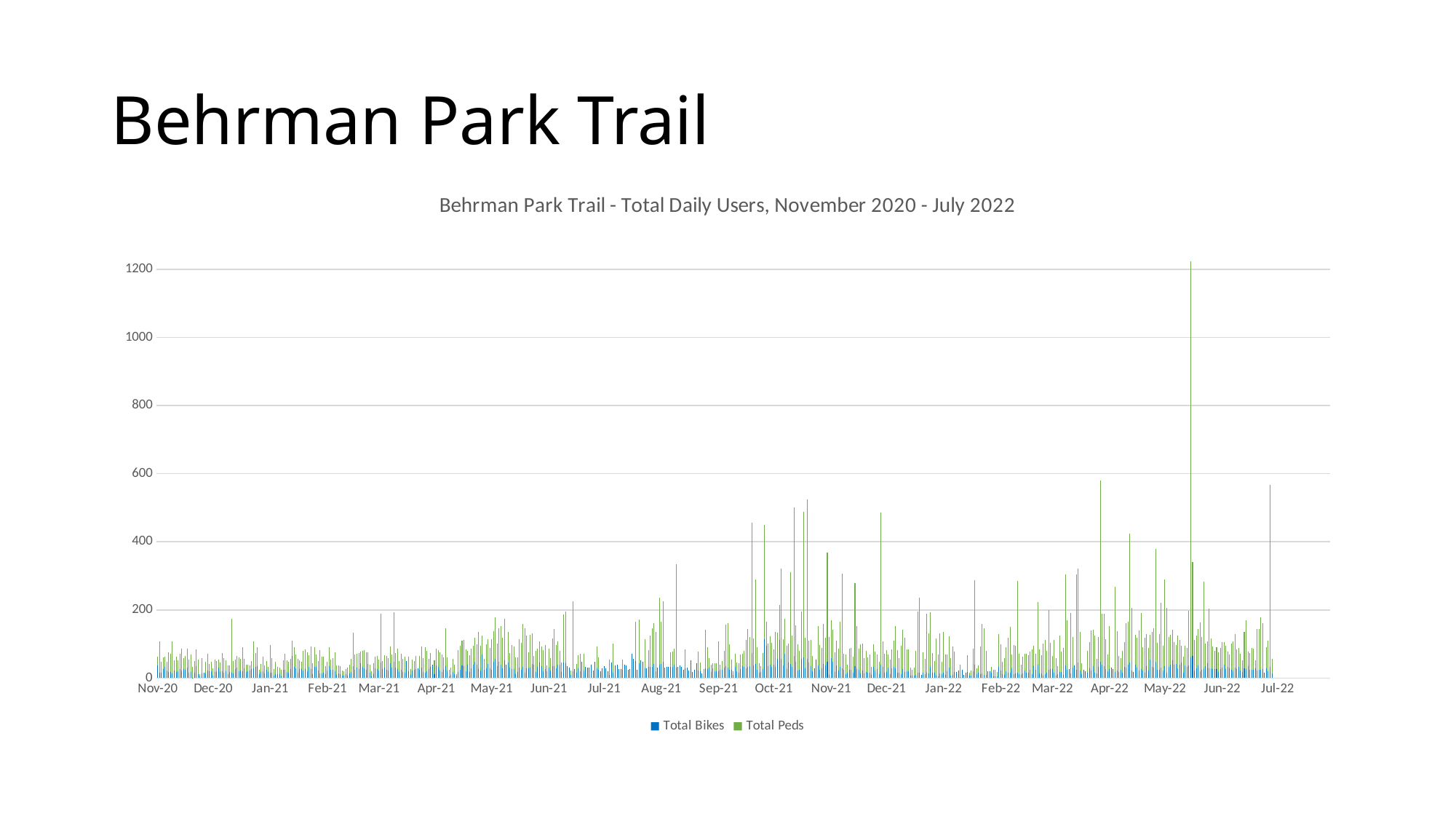
Is the tallest Total Bikes bar greater or less than 200? less Which series generally shows larger daily values, Total Bikes or Total Peds? Total Peds Which series has the tallest bar in the chart? Total Peds Is the tallest Total Peds bar (in May-22) greater or less than 1000? greater How many month labels are shown along the x axis? 21 How many series does the legend list? 2 Do the Total Peds values generally rise or fall from Nov-20 to Oct-21? rise What are the two series named in the legend? Total Bikes and Total Peds What is the highest value shown on the y axis? 1200 What is the title of the chart? Behrman Park Trail - Total Daily Users, November 2020 - July 2022 Is the tallest Total Peds bar in Apr-22 greater or less than 400? greater What kind of chart is shown on the slide? bar chart